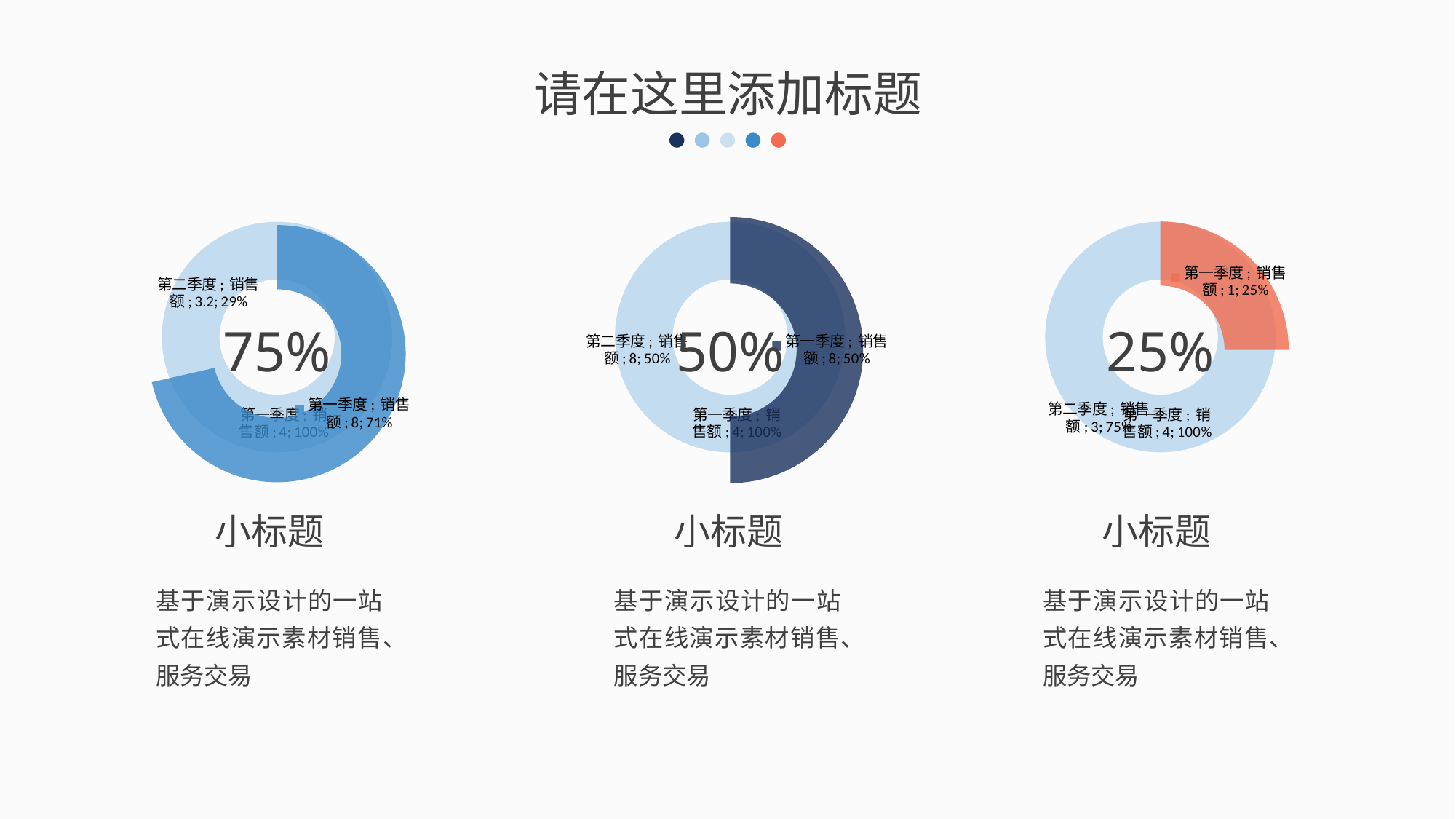
In the middle chart, what percentage share is labelled for 第一季度 in the outer ring? 50% In the left chart, what value is labelled for 第一季度 销售额 in the outer ring? 8 In the right chart, what value is labelled for 第一季度 销售额 in the outer ring? 1 In the middle chart, what value is labelled for 第二季度 销售额? 8 In the right chart, which quarter has the larger outer-ring value, 第一季度 or 第二季度? 第二季度 What large percentage is printed in the centre of the right chart? 25% How many charts are shown on the slide? 3 In the left chart, what value is labelled for 第二季度 销售额? 3.2 In the left chart, what percentage share is labelled for 第二季度? 29% In the right chart, what percentage share is labelled for 第二季度? 75% What kind of chart is the left chart on the slide? doughnut chart